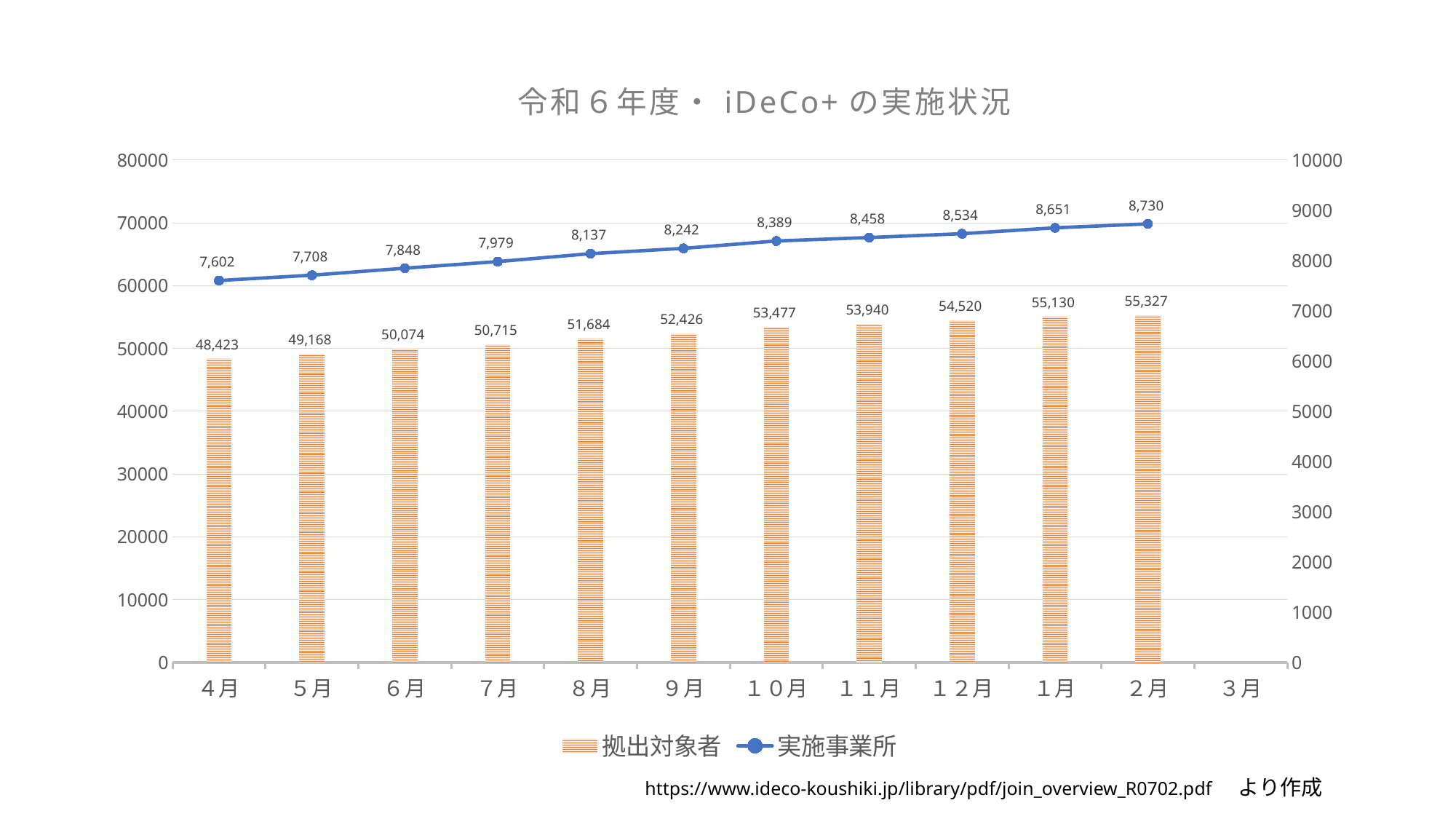
What is the difference between the 拠出対象者 values for 2月 and 4月? 6,904 What is the difference between the 実施事業所 values for 1月 and 12月? 117 What is the value of 拠出対象者 for 10月? 53,477 How many series does the legend list? 2 Which month has the highest value of 拠出対象者? 2月 What is the value of 実施事業所 for 7月? 7,979 What is the title of the chart? 令和６年度・ iDeCo+ の実施状況 Do the 実施事業所 values rise or fall from 4月 to 2月? rise What is the value of 実施事業所 for 2月? 8,730 Which is larger, the 拠出対象者 value for 8月 or for 9月? 9月 What is the value of 拠出対象者 for 4月? 48,423 Which month has the lowest value of 実施事業所? 4月